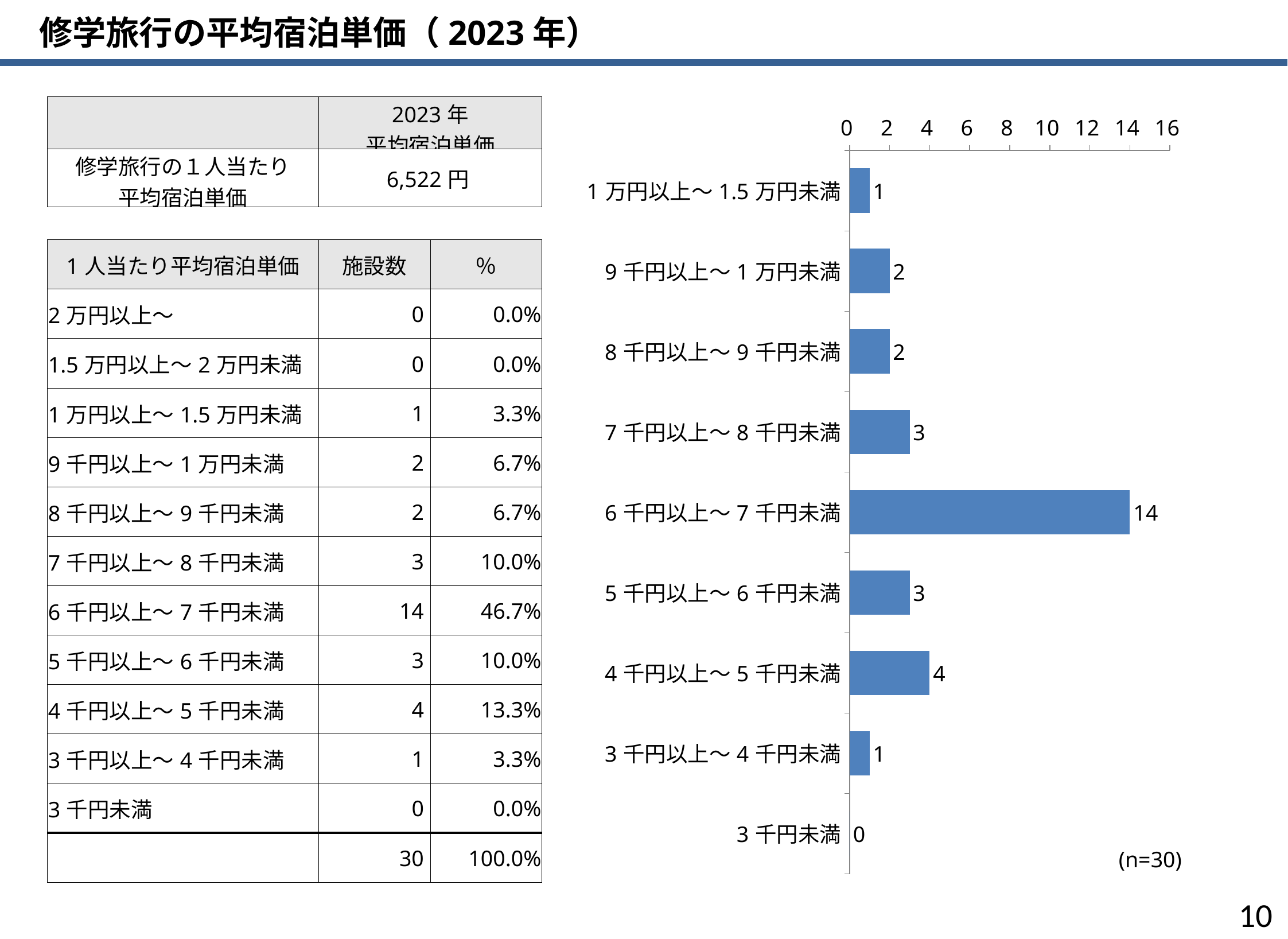
What type of chart is shown on the slide? bar chart Which category has the lowest value in the bar chart? 3千円未満 How many categories does the bar chart show? 9 What is the value for 4千円以上～5千円未満 in the bar chart? 4 Which category has the highest value in the bar chart? 6千円以上～7千円未満 What is the value for 3千円未満 in the bar chart? 0 Is the value for 6千円以上～7千円未満 greater or less than 10? greater What is the difference between the values for 6千円以上～7千円未満 and 4千円以上～5千円未満? 10 What is the value for 6千円以上～7千円未満 in the bar chart? 14 Which is larger in the bar chart: the value for 7千円以上～8千円未満 or the value for 9千円以上～1万円未満? 7千円以上～8千円未満 What is the maximum value shown on the chart's value axis? 16 What is the value for 1万円以上～1.5万円未満 in the bar chart? 1